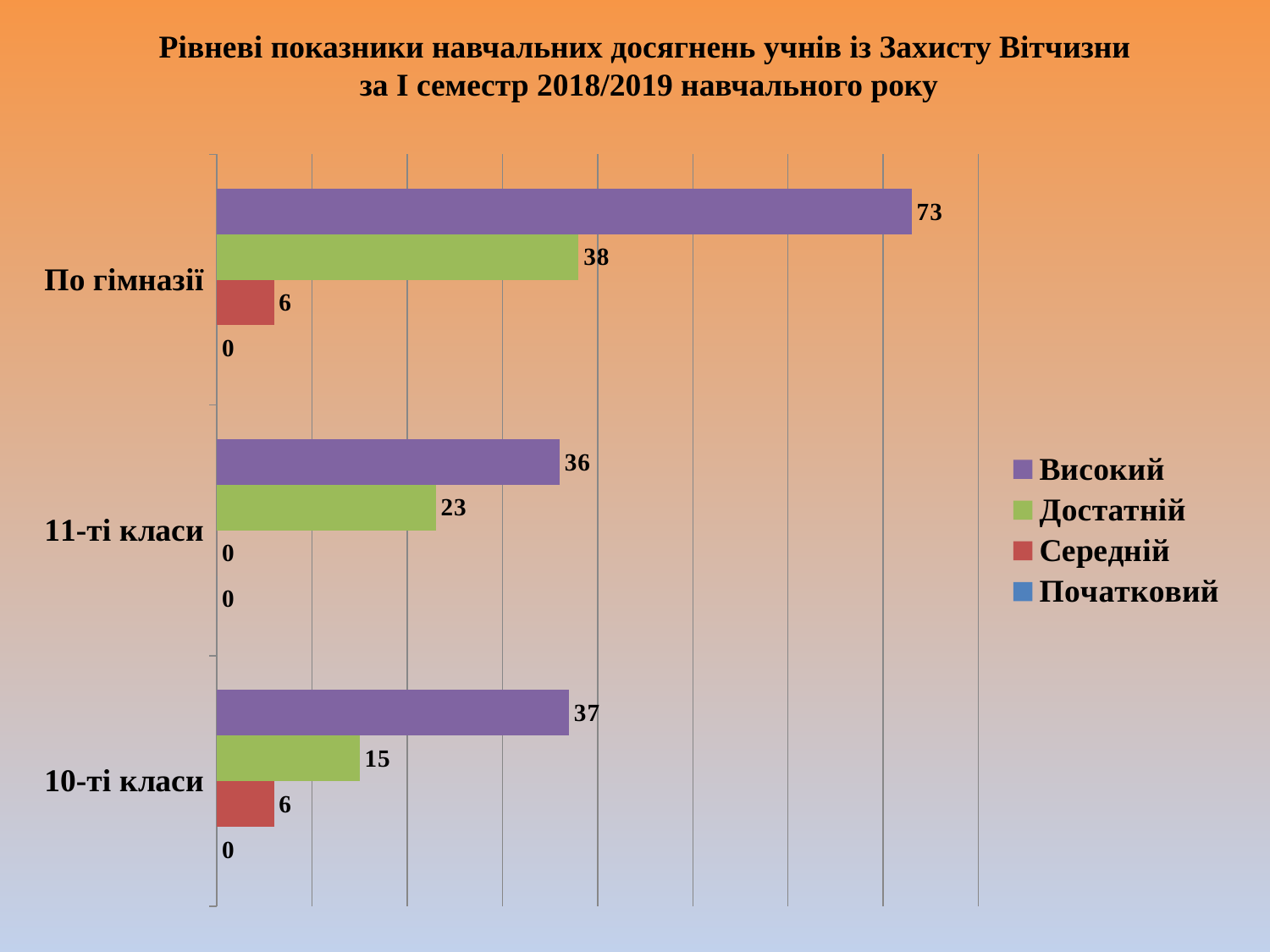
How many series does the legend list? 4 What kind of chart is shown on the slide? Bar chart What is the value for Середній in the 10-ті класи category? 6 What is the value for Високий in the По гімназії category? 73 Which category has the highest value for Високий? По гімназії What is the value for Достатній in the 11-ті класи category? 23 How many categories are shown on the chart? 3 Which colour represents the Достатній series in the legend? Green What is the value for Початковий in the 11-ті класи category? 0 Which is larger: the Достатній value for 11-ті класи or the Достатній value for 10-ті класи? 11-ті класи What is the difference between the Високий value for По гімназії and the Високий value for 11-ті класи? 37 Which category has the lowest value for Достатній? 10-ті класи